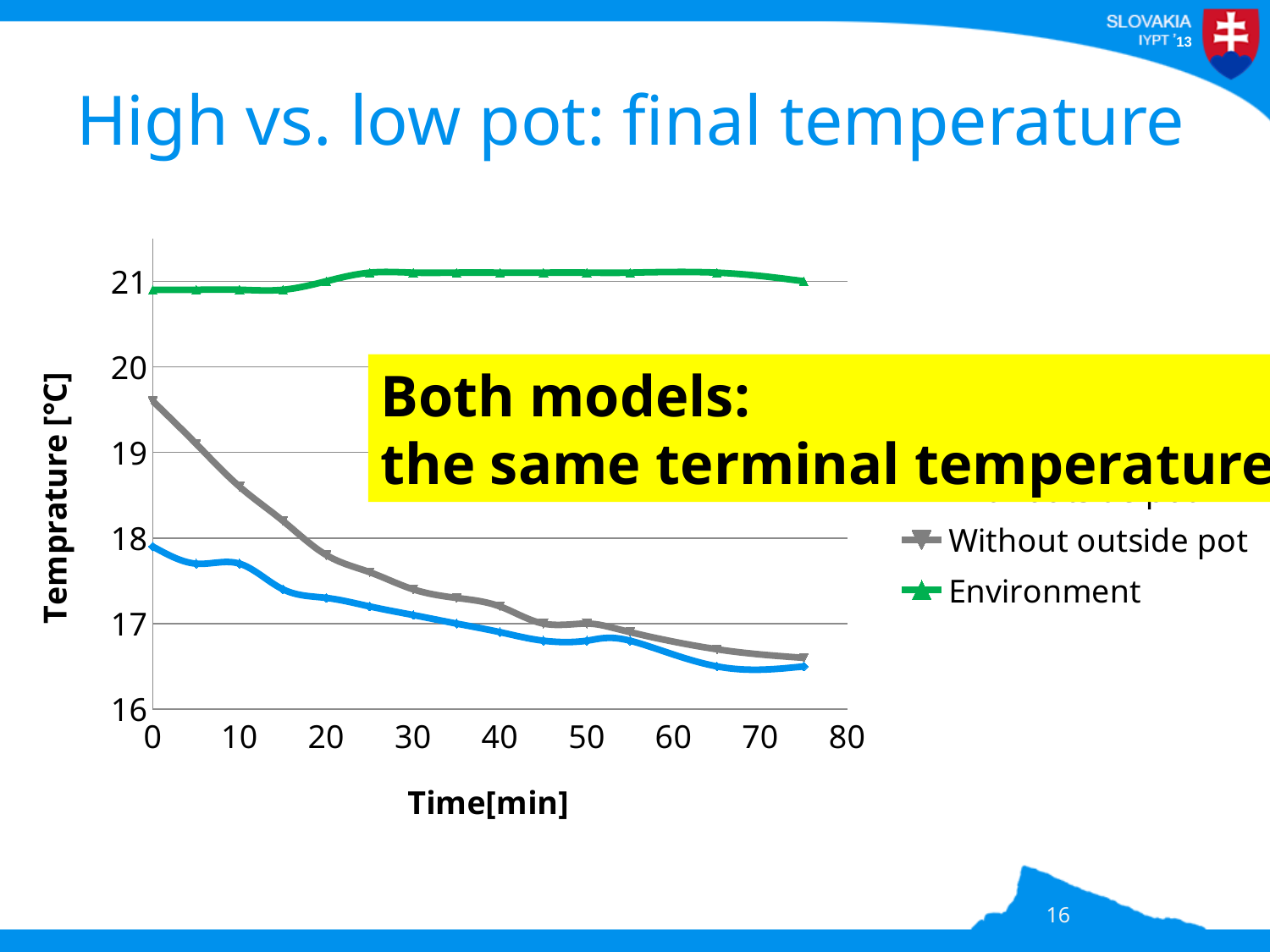
For 'Without outside pot', is the temperature higher at 10 min or at 50 min? 10 min What colour is the 'Environment' line? green Is the 'Without outside pot' temperature at 0 min greater or less than 19? greater Is the 'Without outside pot' temperature at 30 min greater or less than 18? less What kind of chart is shown on the slide? line chart At 75 min, which is higher: 'Environment' or 'Without outside pot'? Environment Is the 'Without outside pot' temperature at 75 min greater or less than 17? less What is the title of the x axis? Time[min] Which series has the highest temperature values throughout the chart? Environment Does the 'Without outside pot' line rise or fall as time increases? fall How many lines are plotted on the chart? 3